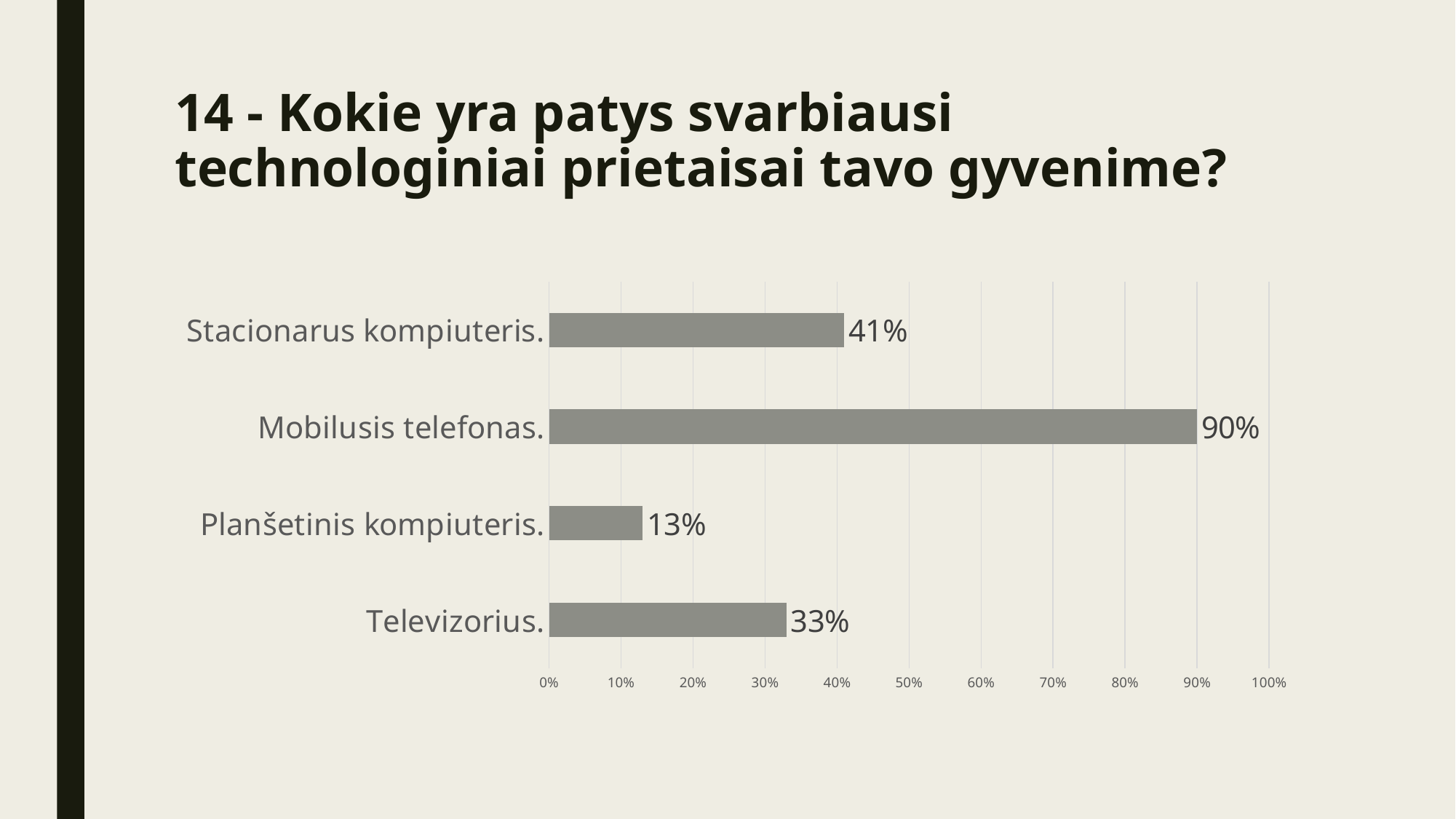
Which is larger, the value for Stacionarus kompiuteris or the value for Televizorius? Stacionarus kompiuteris. How many categories are shown in the chart? 4 Is the value for Televizorius greater or less than 40%? less What is the difference between the values for Televizorius and Planšetinis kompiuteris? 20% What kind of chart is shown on the slide? bar chart What is the value for Televizorius? 33% What is the value for Mobilusis telefonas? 90% Which category has the highest value? Mobilusis telefonas. What is the value for Planšetinis kompiuteris? 13% What is the difference between the values for Mobilusis telefonas and Stacionarus kompiuteris? 49% What is the value for Stacionarus kompiuteris? 41% Which category has the lowest value? Planšetinis kompiuteris.